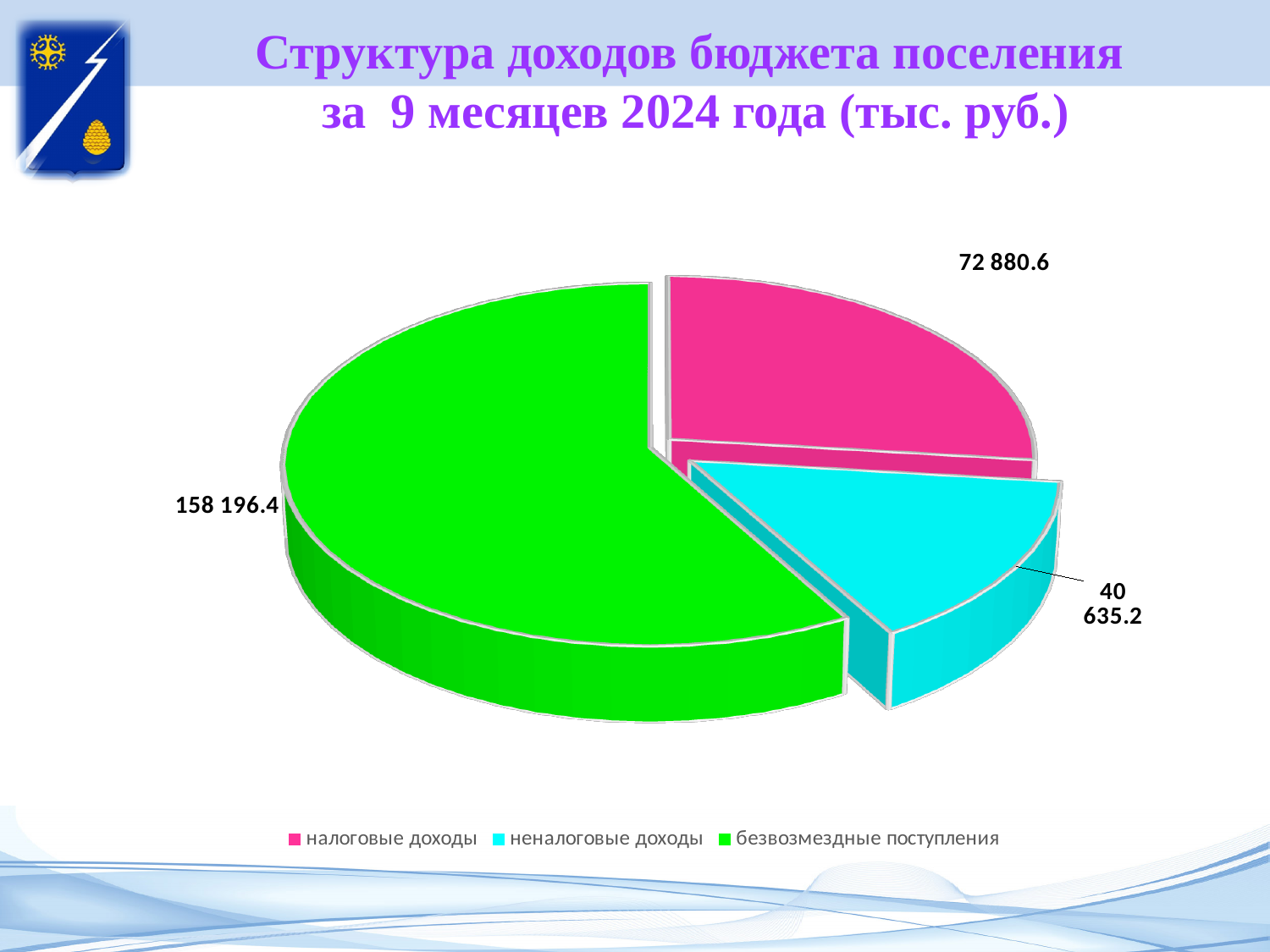
What is the value for налоговые доходы? 72 880.6 How many categories does the pie chart have? 3 What is the difference between безвозмездные поступления and налоговые доходы? 85 315.8 What colour is the slice for безвозмездные поступления? green Which category has the largest slice of the pie? безвозмездные поступления What type of chart is shown on the slide? pie chart Which is larger, налоговые доходы or неналоговые доходы? налоговые доходы What is the value for безвозмездные поступления? 158 196.4 What is the value for неналоговые доходы? 40 635.2 What is the total of all slices in the pie chart? 271 712.2 Which category has the smallest slice of the pie? неналоговые доходы What is the difference between налоговые доходы and неналоговые доходы? 32 245.4